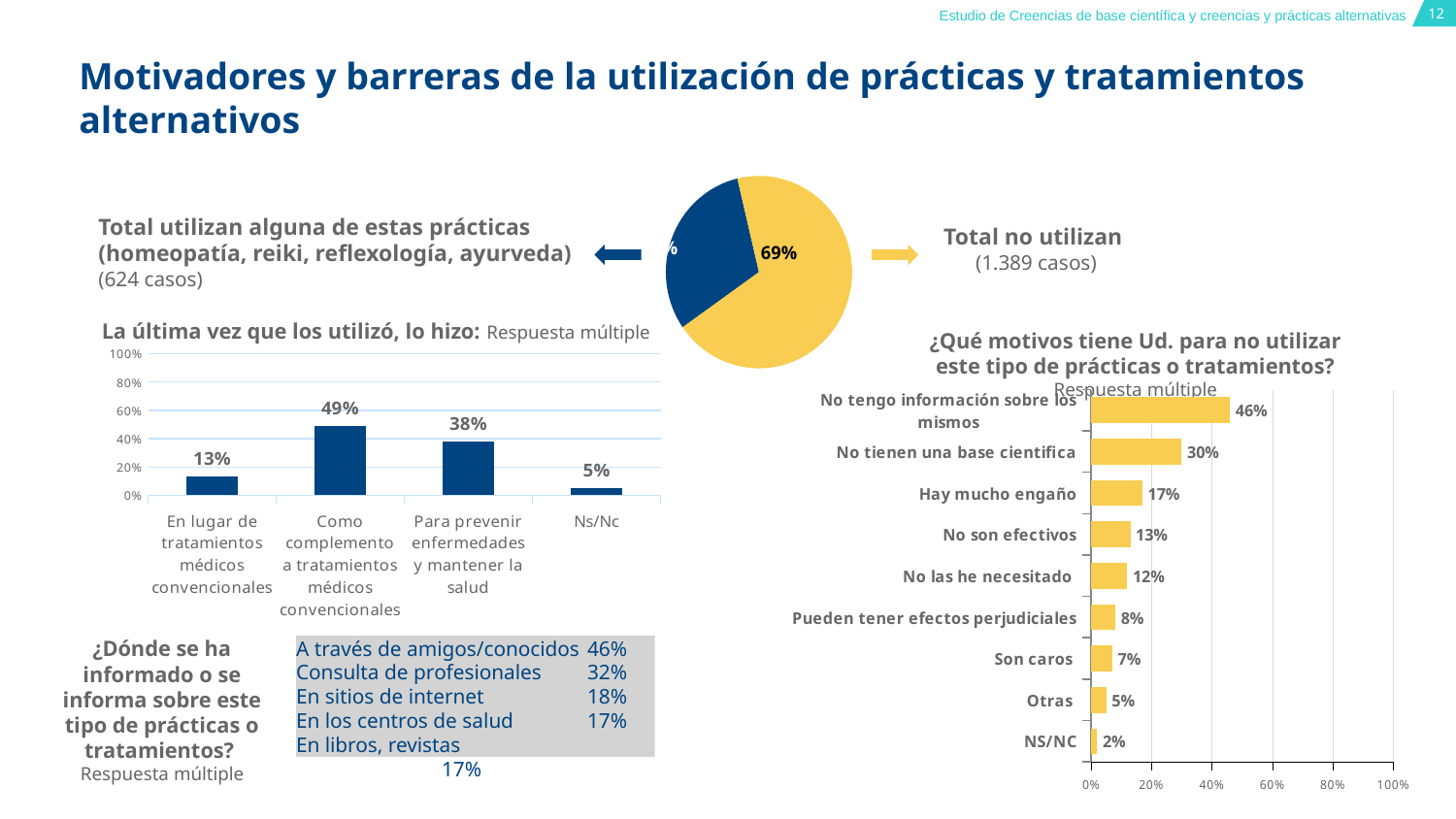
In the chart '¿Qué motivos tiene Ud. para no utilizar este tipo de prácticas o tratamientos?', which category has the highest value? No tengo información sobre los mismos What kind of chart is '¿Qué motivos tiene Ud. para no utilizar este tipo de prácticas o tratamientos?'? Bar chart In the chart 'La última vez que los utilizó, lo hizo:', is the value for 'En lugar de tratamientos médicos convencionales' greater or less than 20%? less In the chart 'La última vez que los utilizó, lo hizo:', how many categories are shown on the x axis? 4 In the chart '¿Qué motivos tiene Ud. para no utilizar este tipo de prácticas o tratamientos?', what is the value for 'Hay mucho engaño'? 17% In the chart 'La última vez que los utilizó, lo hizo:', what is the value for 'Como complemento a tratamientos médicos convencionales'? 49% In the pie chart at the top centre of the slide, what share does the yellow slice show? 69% In the chart 'La última vez que los utilizó, lo hizo:', what is the difference between 'Como complemento a tratamientos médicos convencionales' and 'Para prevenir enfermedades y mantener la salud'? 11% In the chart 'La última vez que los utilizó, lo hizo:', which category has the lowest value? Ns/Nc In the chart '¿Qué motivos tiene Ud. para no utilizar este tipo de prácticas o tratamientos?', how many categories are listed? 9 In the chart '¿Qué motivos tiene Ud. para no utilizar este tipo de prácticas o tratamientos?', what is the difference between 'No tienen una base científica' and 'Son caros'? 23% In the chart '¿Qué motivos tiene Ud. para no utilizar este tipo de prácticas o tratamientos?', which is larger: 'No son efectivos' or 'No las he necesitado'? No son efectivos